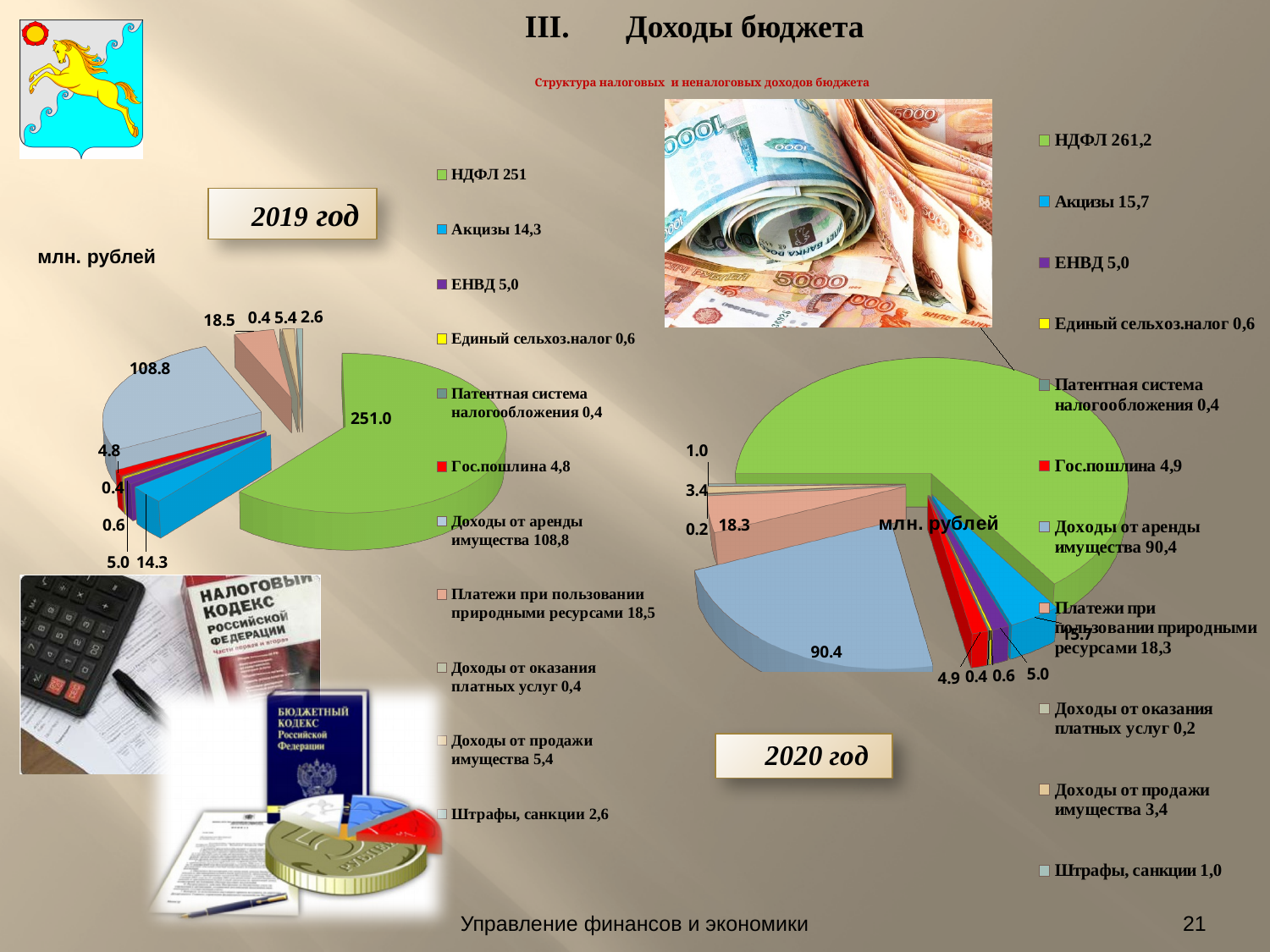
In the 2020 год chart, what is the value for Штрафы, санкции? 1,0 In the 2020 год chart, which category has the smallest value? Доходы от оказания платных услуг By how much is НДФЛ in the 2020 год chart larger than НДФЛ in the 2019 год chart? 10,2 In what units are the values in the two pie charts given? млн. рублей In the 2019 год chart, which is larger: Платежи при пользовании природными ресурсами or Акцизы? Платежи при пользовании природными ресурсами What kind of chart is used for the 2019 год chart on the left? pie chart What is the difference between Доходы от аренды имущества in the 2019 год chart and in the 2020 год chart? 18,4 Is the value for Акцизы larger in the 2019 год chart or in the 2020 год chart? 2020 год In the 2020 год chart, what is the value for Доходы от аренды имущества? 90,4 In the 2019 год chart, what is the value for НДФЛ? 251 In the 2019 год chart, which category has the largest value? НДФЛ How many categories does the 2019 год chart show? 11